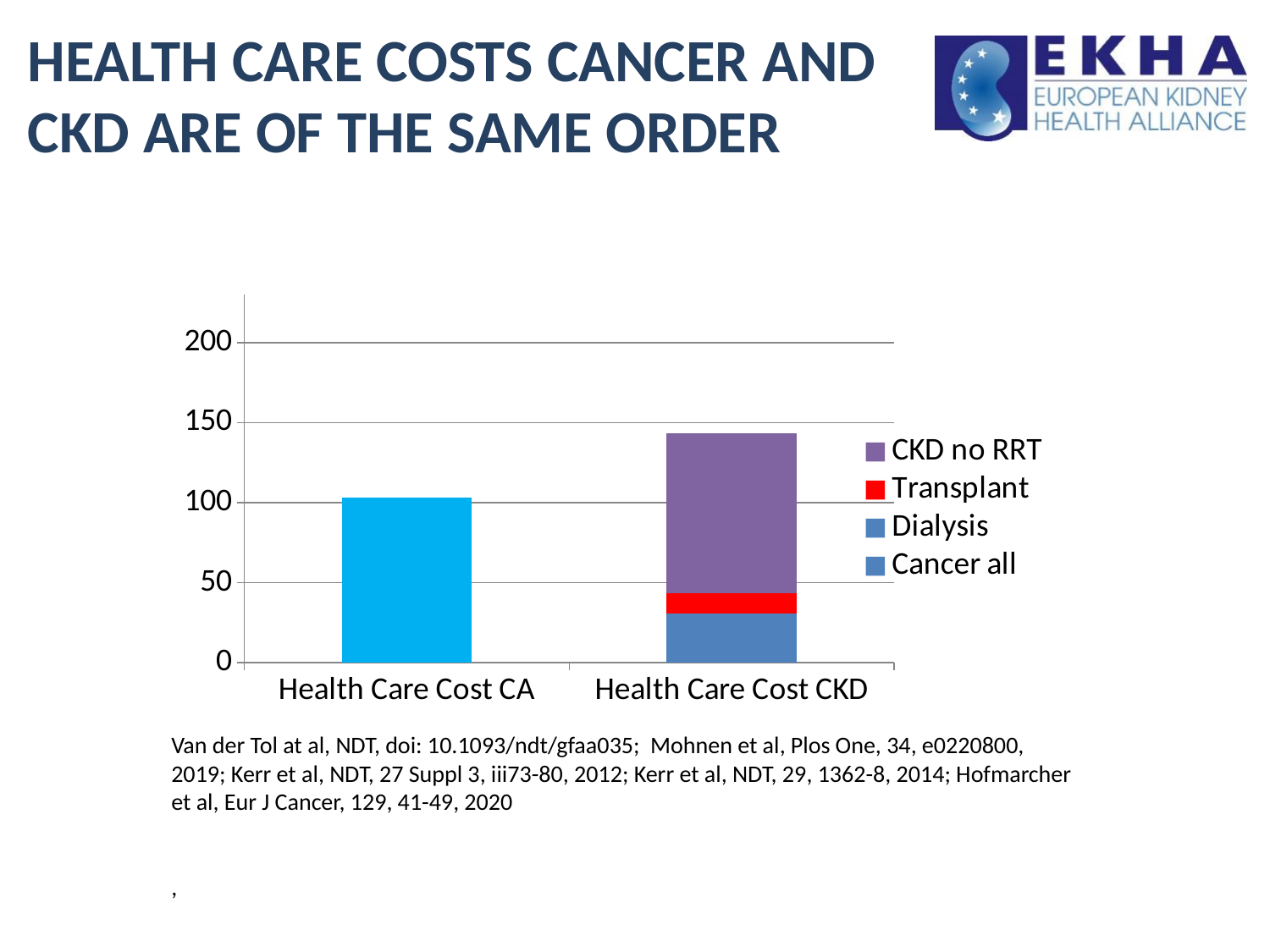
Is the value for Health Care Cost CA greater or less than 150? less Which category has the taller total bar, Health Care Cost CA or Health Care Cost CKD? Health Care Cost CKD What kind of chart is shown on the slide? bar chart How many series does the chart's legend list? 4 Which category has the lowest total bar? Health Care Cost CA How many categories are shown on the x axis of the chart? 2 Is the Dialysis segment of the Health Care Cost CKD bar greater or less than 50? less Which legend entry is listed first in the chart's legend? CKD no RRT Which legend entry is shown in red? Transplant Which category has the highest total bar? Health Care Cost CKD Is the total value for Health Care Cost CKD greater or less than 150? less